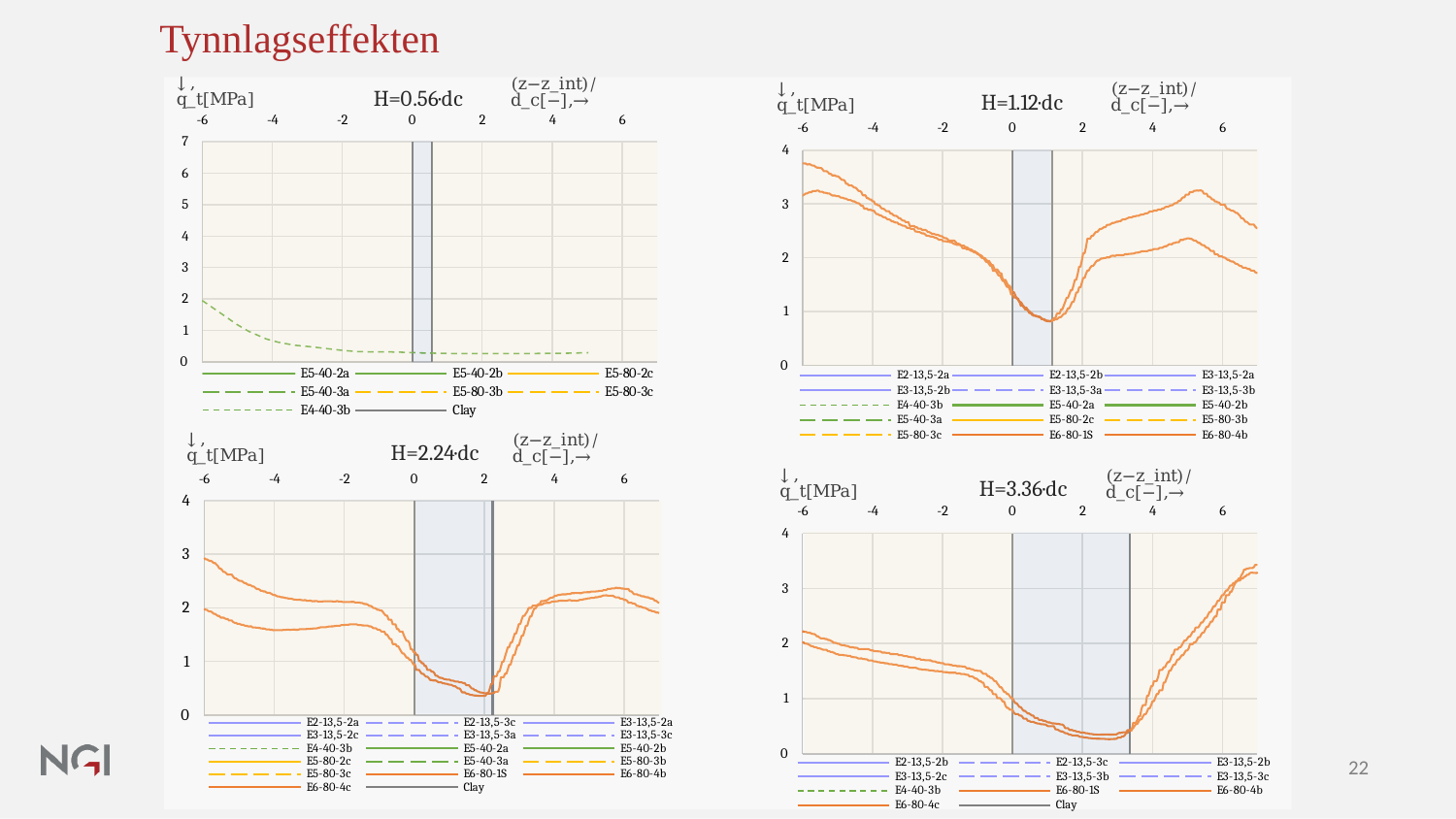
How many charts are shown on the slide? 4 What is the highest value shown on the y axis of the chart titled H=0.56·dc? 7 In the chart titled H=0.56·dc, does the plotted line rise or fall as the x axis goes from -6 to 6? Fall In the chart titled H=1.12·dc, is the value of the upper line at x = -6 greater or less than 3? greater What is the title of the slide? Tynnlagseffekten How many series does the legend of the chart titled H=3.36·dc list? 11 In the chart titled H=0.56·dc, is the value of the plotted line at x = -6 greater or less than 1? greater In the chart titled H=3.36·dc, do the plotted lines rise or fall as the x axis goes from 2 to 6? Rise In the chart titled H=2.24·dc, are the plotted values at x = 2 greater or less than 1? less What kind of chart is the chart titled H=0.56·dc? Line chart How many series does the legend of the chart titled H=0.56·dc list? 8